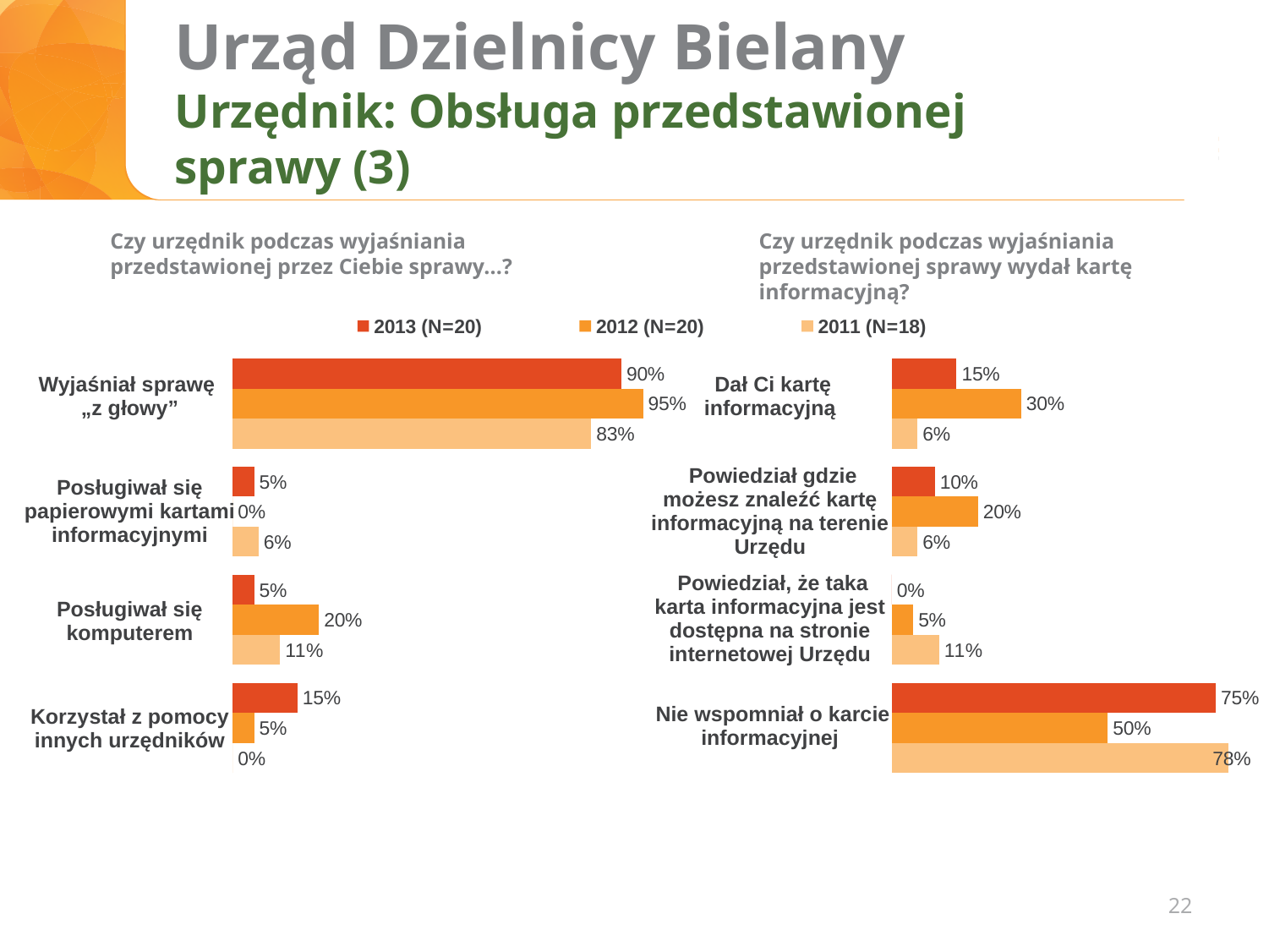
In the right chart, what is the 2011 value for "Nie wspomniał o karcie informacyjnej"? 78% What type of chart is the left chart? Bar chart In the left chart, what is the 2011 value for "Korzystał z pomocy innych urzędników"? 0% In the right chart, which is larger for "Nie wspomniał o karcie informacyjnej": the 2013 value or the 2012 value? 2013 In the left chart, what is the difference between the 2012 and 2011 values for "Wyjaśniał sprawę „z głowy”"? 12 percentage points In the left chart, which category has the highest 2012 value? Wyjaśniał sprawę „z głowy” How many series does the legend list? 3 In the left chart ("Czy urzędnik podczas wyjaśniania przedstawionej przez Ciebie sprawy...?"), what is the 2013 value for "Wyjaśniał sprawę „z głowy”"? 90% In the right chart ("Czy urzędnik podczas wyjaśniania przedstawionej sprawy wydał kartę informacyjną?"), what is the 2012 value for "Dał Ci kartę informacyjną"? 30% In the left chart, what is the 2012 value for "Posługiwał się komputerem"? 20% In the right chart, what is the difference between the 2013 and 2012 values for "Nie wspomniał o karcie informacyjnej"? 25 percentage points In the right chart, which category has the lowest 2013 value? Powiedział, że taka karta informacyjna jest dostępna na stronie internetowej Urzędu